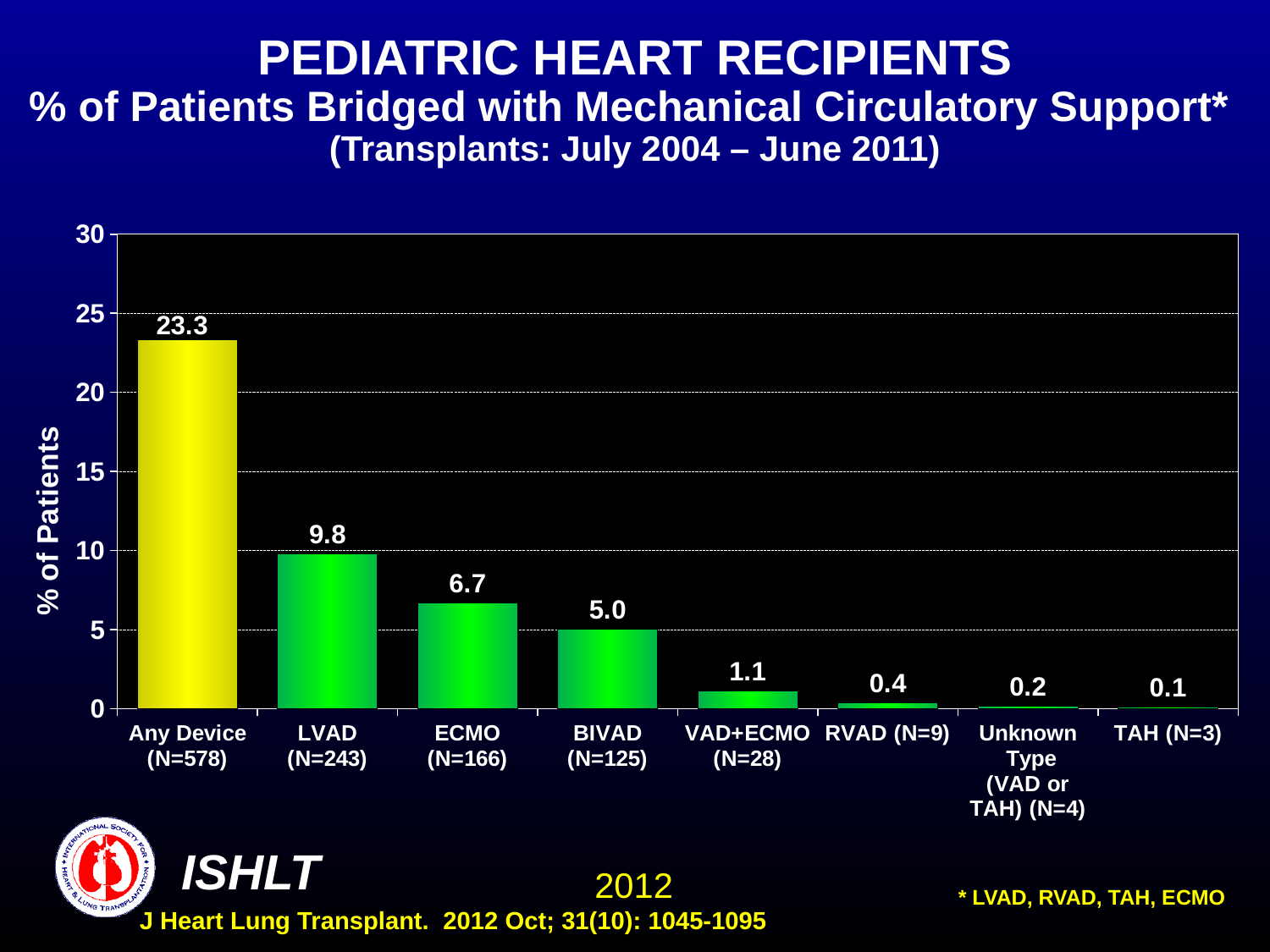
What is the label of the y axis? % of Patients What is the value for ECMO (N=166)? 6.7 What is the value for LVAD (N=243)? 9.8 What is the value for Any Device (N=578)? 23.3 Is the value for Any Device (N=578) greater or less than 20? greater What is the value for VAD+ECMO (N=28)? 1.1 Which category has the lowest value? TAH (N=3) What kind of chart is shown on the slide? bar chart Which category has the highest value? Any Device (N=578) What is the difference between the values for LVAD (N=243) and ECMO (N=166)? 3.1 Which is larger, the value for BIVAD (N=125) or the value for ECMO (N=166)? ECMO (N=166) How many categories are shown on the x axis? 8